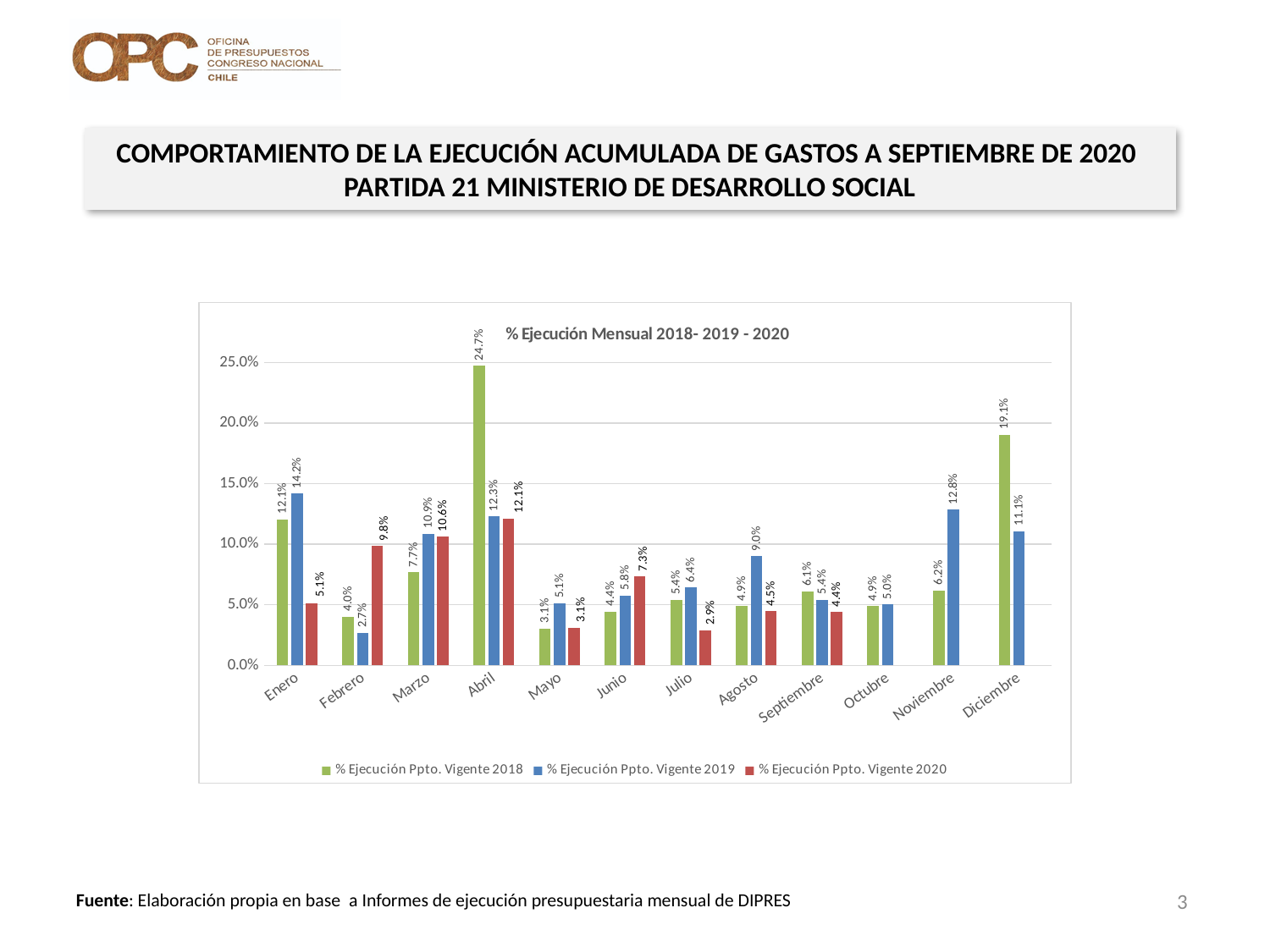
How many series does the legend list? 3 Which is larger in Agosto: the 2019 value or the 2020 value? 2019 What is the title of the chart? % Ejecución Mensual 2018- 2019 - 2020 Which month has the highest value for % Ejecución Ppto. Vigente 2019? Enero What type of chart is shown on the slide? bar chart What is the value for % Ejecución Ppto. Vigente 2020 in Septiembre? 4.4% What is the difference between the 2018 and 2019 values in Diciembre? 8.0% Which month has the lowest value for % Ejecución Ppto. Vigente 2020? Julio What is the value for % Ejecución Ppto. Vigente 2018 in Abril? 24.7% How many months are shown on the x axis? 12 What is the value for % Ejecución Ppto. Vigente 2019 in Noviembre? 12.8% What is the value for % Ejecución Ppto. Vigente 2020 in Febrero? 9.8%